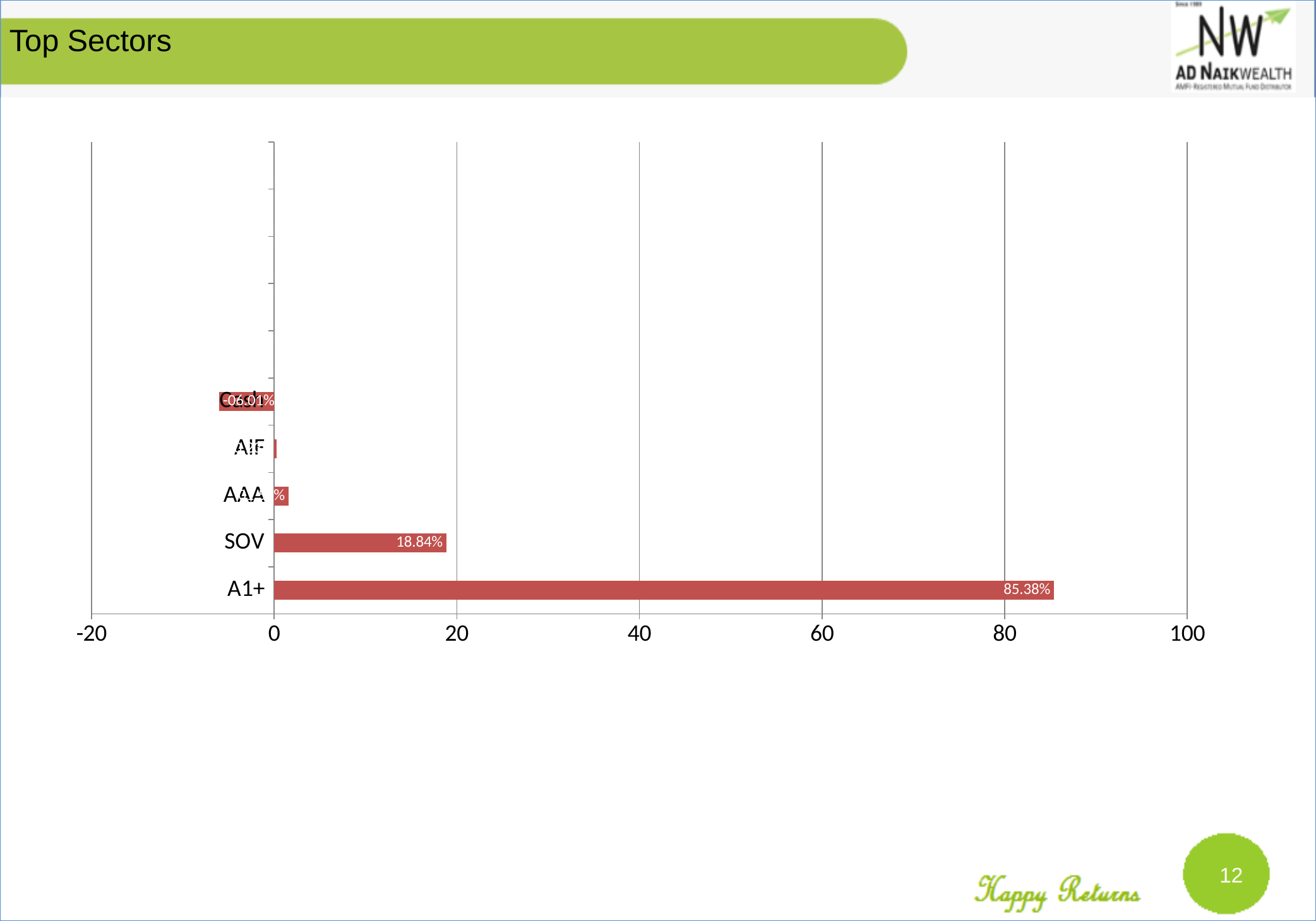
What kind of chart is shown on the slide? bar chart Which is larger, the value for SOV or the value for A1+? A1+ Which category has the lowest value? Cash Is the value for Cash greater or less than 0? less What is the value for SOV? 18.84% What is the difference between the values for A1+ and SOV? 66.54% What is the title of the slide? Top Sectors Is the value for A1+ greater or less than 80? greater How many categories are shown in the chart? 5 What is the value for A1+? 85.38% Which category has the highest value? A1+ Is the value for AAA greater or less than 20? less